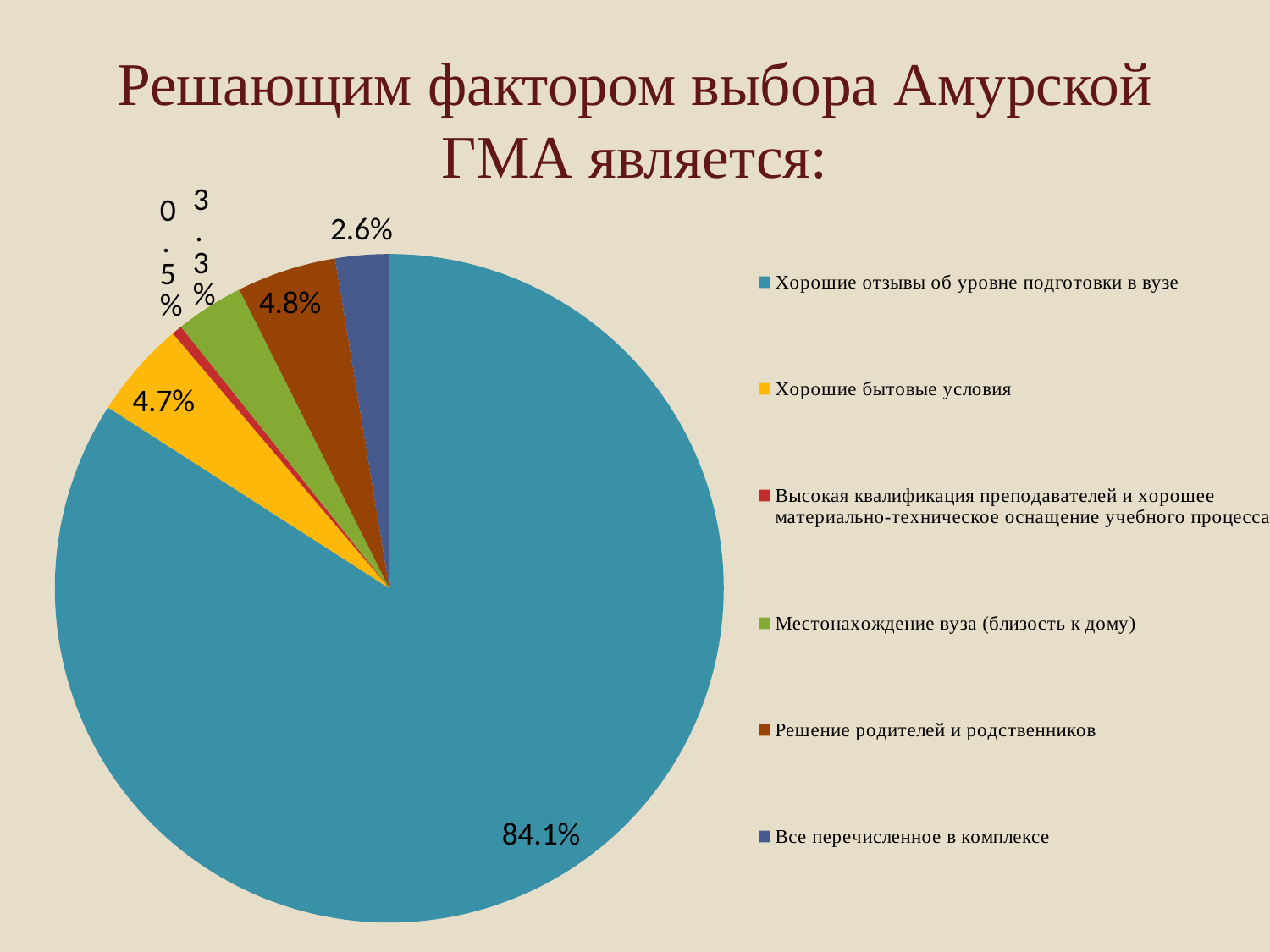
What is the value for "Хорошие бытовые условия"? 4.7% What is the value for "Решение родителей и родственников"? 4.8% What kind of chart is shown on the slide? pie chart How many categories does the pie chart have? 6 What is the difference between the values for "Хорошие бытовые условия" and "Все перечисленное в комплексе"? 2.1% Which category has the smallest slice of the pie? Высокая квалификация преподавателей и хорошее материально-техническое оснащение учебного процесса What share of the pie does "Хорошие отзывы об уровне подготовки в вузе" have? 84.1% Which is larger: the value for "Местонахождение вуза (близость к дому)" or the value for "Все перечисленное в комплексе"? Местонахождение вуза (близость к дому) What is the value for "Все перечисленное в комплексе"? 2.6% Which category has the largest slice of the pie? Хорошие отзывы об уровне подготовки в вузе What colour is the slice for "Хорошие бытовые условия"? yellow What is the value for "Местонахождение вуза (близость к дому)"? 3.3%